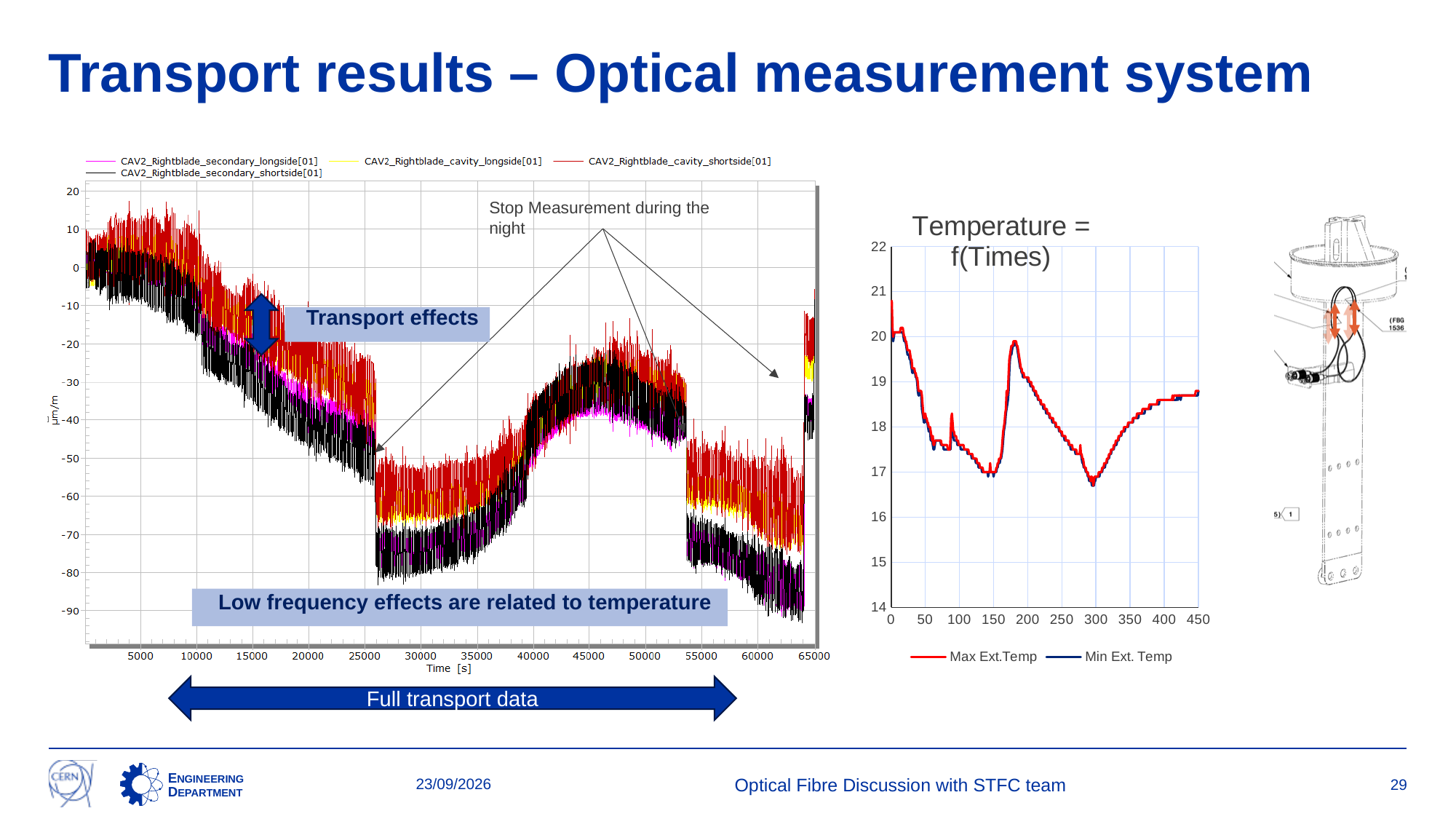
In the left chart (y axis µm/m), are the values at 30000 s greater or less than -40? less In the 'Temperature = f(Times)' chart, does the temperature rise or fall between time 300 and time 450? rise What is the x axis label of the left chart (y axis µm/m)? Time [s] In the 'Temperature = f(Times)' chart, is the temperature at time 450 greater or less than 18? greater In the 'Temperature = f(Times)' chart, is the temperature at time 150 greater or less than 18? less What kind of chart is the chart on the right titled 'Temperature = f(Times)'? line chart What kind of chart is the large chart on the left with the y axis labelled µm/m? line chart How many series does the legend of the left chart (y axis µm/m) list? 4 In the 'Temperature = f(Times)' chart, does the temperature rise or fall between time 0 and time 150? fall How many series does the legend of the 'Temperature = f(Times)' chart list? 2 What are the two legend entries of the 'Temperature = f(Times)' chart? Max Ext.Temp and Min Ext. Temp